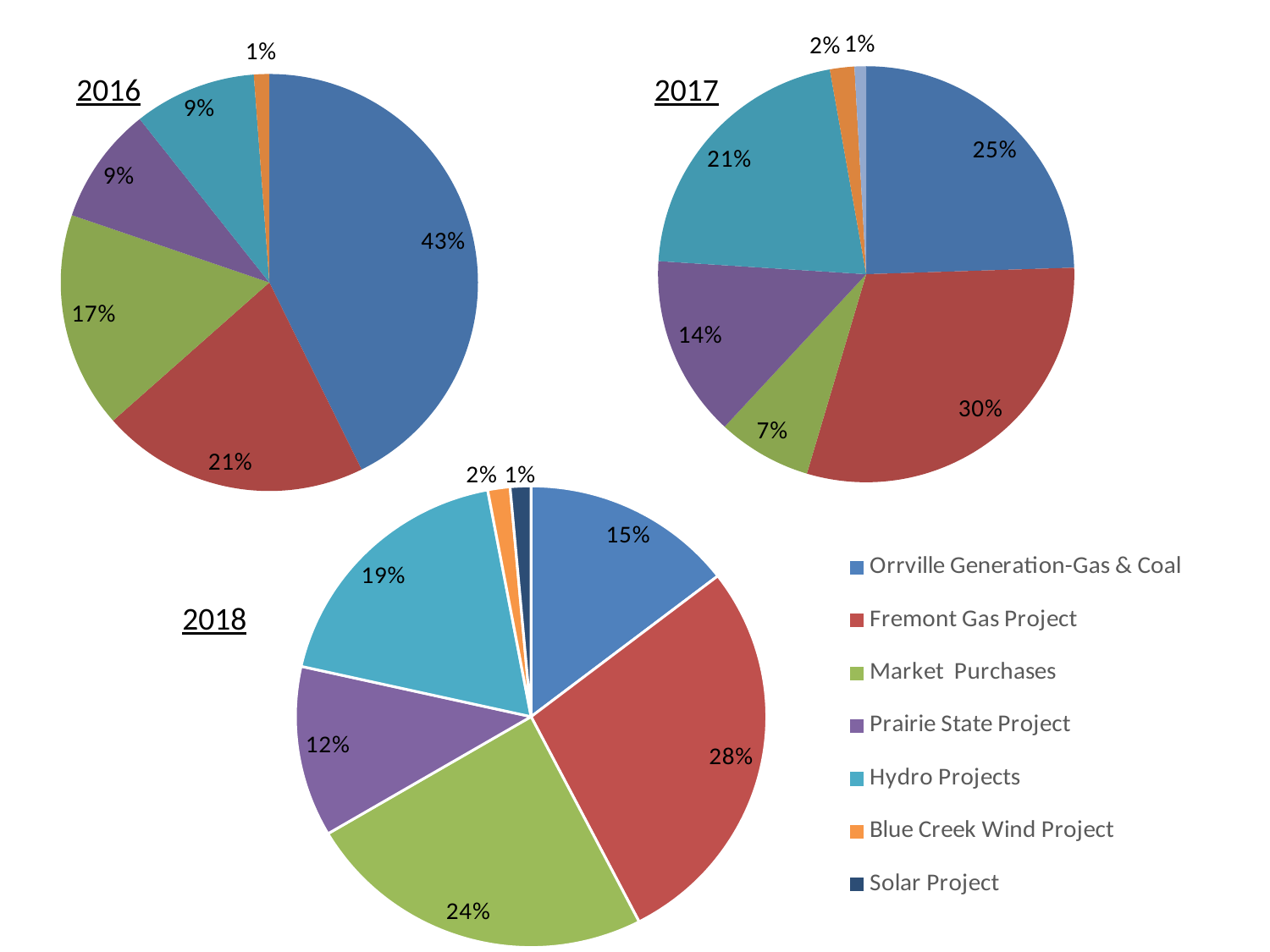
In the 2018 pie chart, what share does Market Purchases have? 24% In the 2018 pie chart, which category has the largest slice? Fremont Gas Project In the 2016 pie chart, what share does Orrville Generation-Gas & Coal have? 43% In the 2017 pie chart, what share does Fremont Gas Project have? 30% In the 2017 pie chart, what is the difference between the Hydro Projects share and the Market Purchases share? 14% In the 2018 pie chart, which is larger: Hydro Projects or Prairie State Project? Hydro Projects How many slices does the 2016 pie chart have? 6 What kind of charts are shown on the slide? Pie charts How many categories does the legend list? 7 In the 2016 pie chart, which category has the largest slice? Orrville Generation-Gas & Coal In the 2017 pie chart, which category has the smallest labelled slice? Solar Project